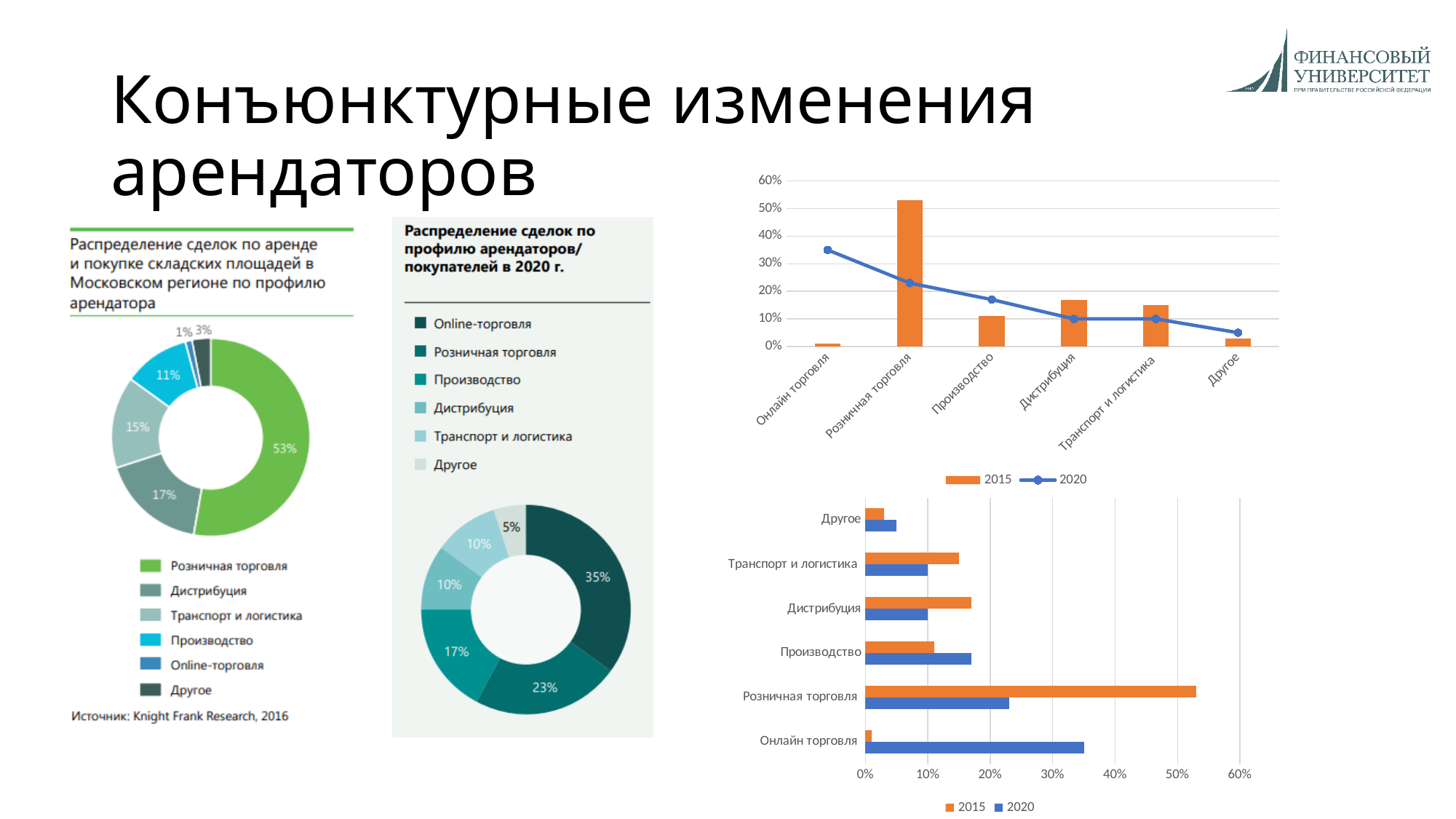
In the left donut chart (2016 source), what is the difference between the shares of Транспорт и логистика and Производство? 4% In the top-right chart with bars and a line, is the 2015 bar for Розничная торговля greater or less than 50%? greater In the middle donut chart (2020), which category has the largest share? Online-торговля In the middle donut chart (2020), what is the difference between Розничная торговля and Производство? 6% What kind of chart is the bottom-right chart? bar chart In the left donut chart (2016 source), which category has the smallest share? Online-торговля In the top-right chart with bars and a line, is the 2020 value for Онлайн торговля greater or less than 30%? greater In the top-right chart with bars and a line, does the 2020 line rise or fall from Онлайн торговля to Другое? fall In the middle donut chart (2020), how many categories does the legend list? 6 In the left donut chart (Распределение сделок по аренде и покупке складских площадей в Московском регионе по профилю арендатора), what share does Розничная торговля have? 53% In the left donut chart (2016 source), what is the share for Дистрибуция? 17% In the middle donut chart (Распределение сделок по профилю арендаторов/покупателей в 2020 г.), what share does Online-торговля have? 35%